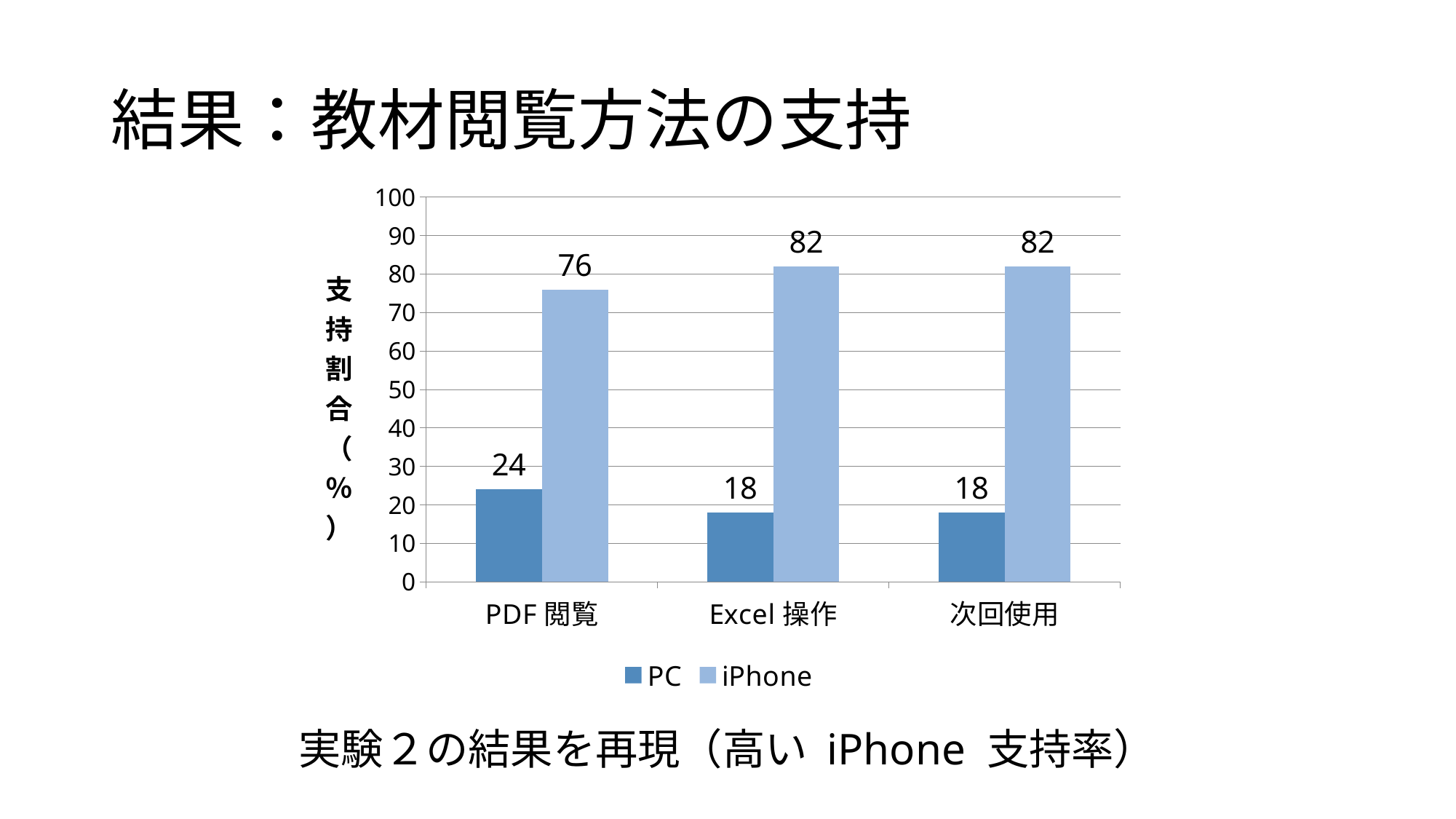
What is the value for PC in the Excel 操作 category? 18 Which category has the lowest iPhone value? PDF 閲覧 What are the two series listed in the legend? PC and iPhone How many categories are shown on the x axis? 3 What kind of chart is shown on the slide? Bar chart What is the value for iPhone in the PDF 閲覧 category? 76 Which category has the highest PC value? PDF 閲覧 What is the difference between the iPhone and PC values in the PDF 閲覧 category? 52 How many series does the legend list? 2 What is the value for iPhone in the 次回使用 category? 82 Which is larger in the Excel 操作 category, PC or iPhone? iPhone What is the difference between the iPhone values for Excel 操作 and PDF 閲覧? 6